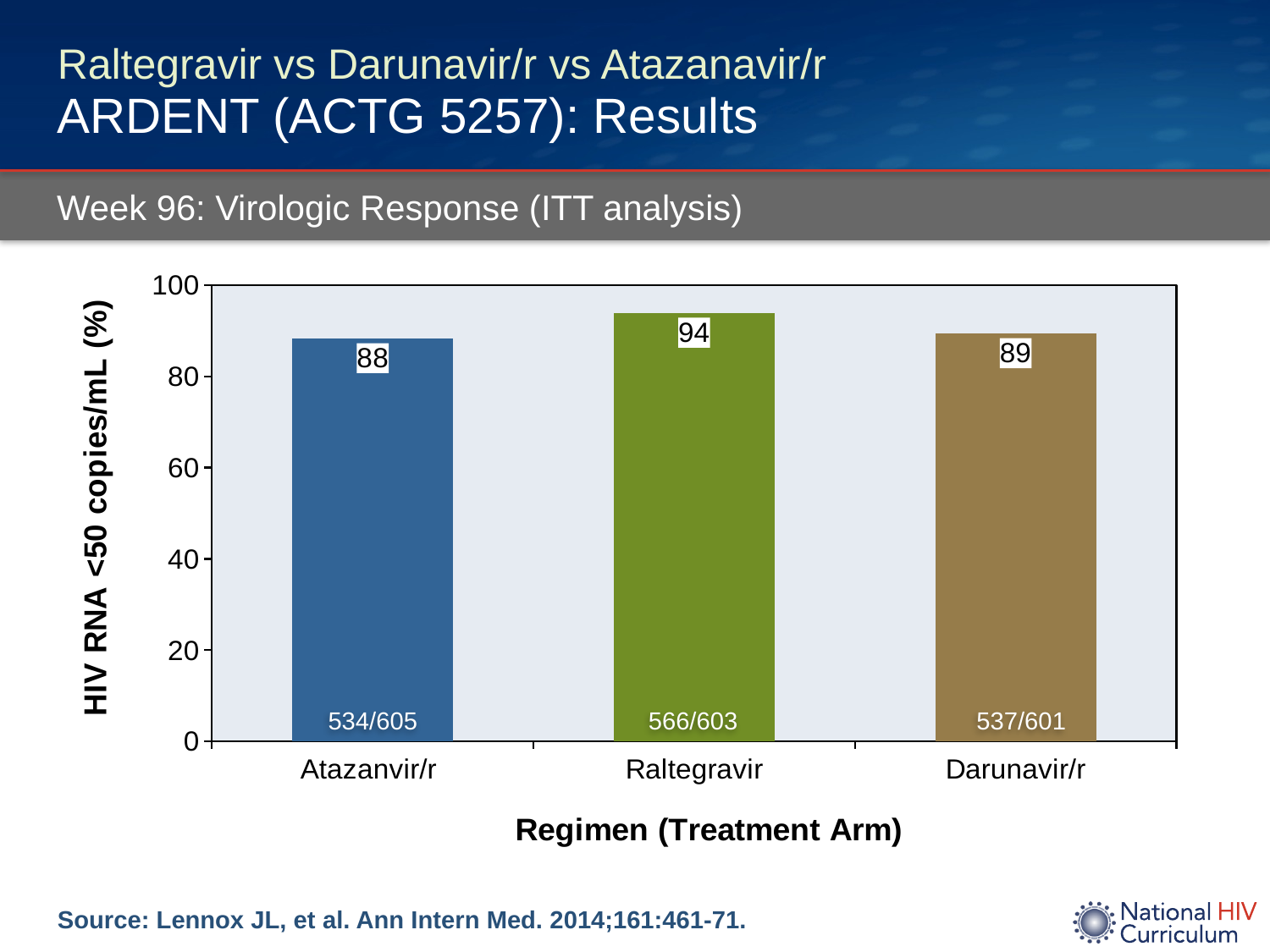
What kind of chart is shown on the slide? Bar chart Which regimen has the lowest virologic response? Atazanvir/r What fraction is printed at the base of the Raltegravir bar? 566/603 What is the value for Atazanvir/r? 88 What is the value for Raltegravir? 94 Which regimen has the highest virologic response? Raltegravir What is the value for Darunavir/r? 89 What is the difference between the values for Raltegravir and Atazanvir/r? 6 Is the value for Atazanvir/r greater or less than 80? greater How many treatment arms are shown in the chart? 3 Which is larger, the value for Raltegravir or the value for Darunavir/r? Raltegravir What is the difference between the values for Raltegravir and Darunavir/r? 5